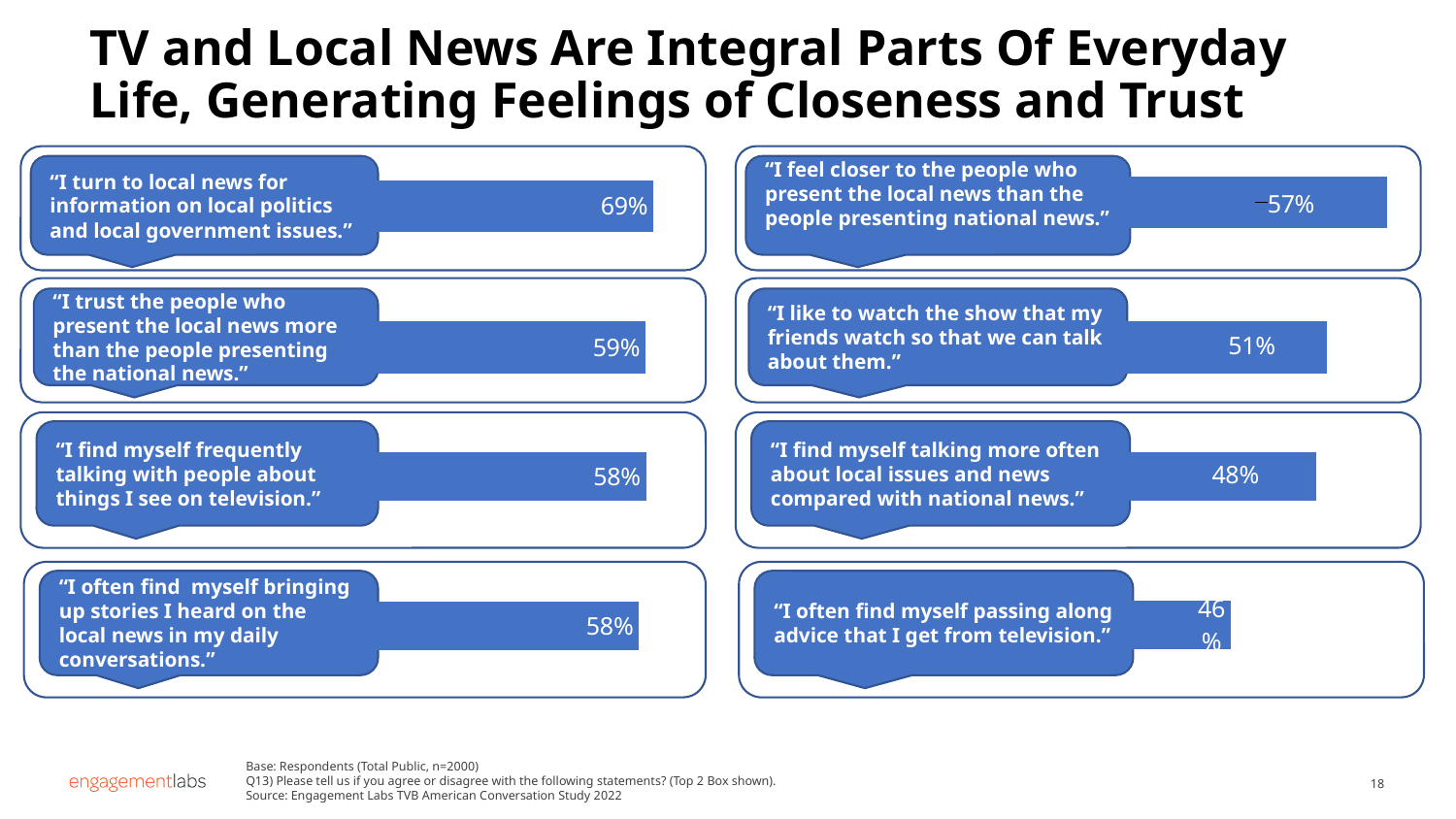
Which statement has the highest level of agreement on the slide? "I turn to local news for information on local politics and local government issues." Which statement has the lowest level of agreement on the slide? "I often find myself passing along advice that I get from television." What is the title of the slide? TV and Local News Are Integral Parts Of Everyday Life, Generating Feelings of Closeness and Trust What percentage agree with "I trust the people who present the local news more than the people presenting the national news"? 59% What percentage agree with "I feel closer to the people who present the local news than the people presenting national news"? 57% How many statements are shown with bars on the slide? 8 What percentage of respondents agree with the statement "I turn to local news for information on local politics and local government issues"? 69% What percentage agree with "I often find myself passing along advice that I get from television"? 46% What is the difference in agreement between "I turn to local news for information on local politics and local government issues" (69%) and "I often find myself passing along advice that I get from television" (46%)? 23 percentage points Which has higher agreement: "I like to watch the show that my friends watch so that we can talk about them" or "I find myself talking more often about local issues and news compared with national news"? "I like to watch the show that my friends watch so that we can talk about them" (51%) What percentage agree with "I like to watch the show that my friends watch so that we can talk about them"? 51% What kind of chart is used to show the agreement levels on the slide? Bar chart